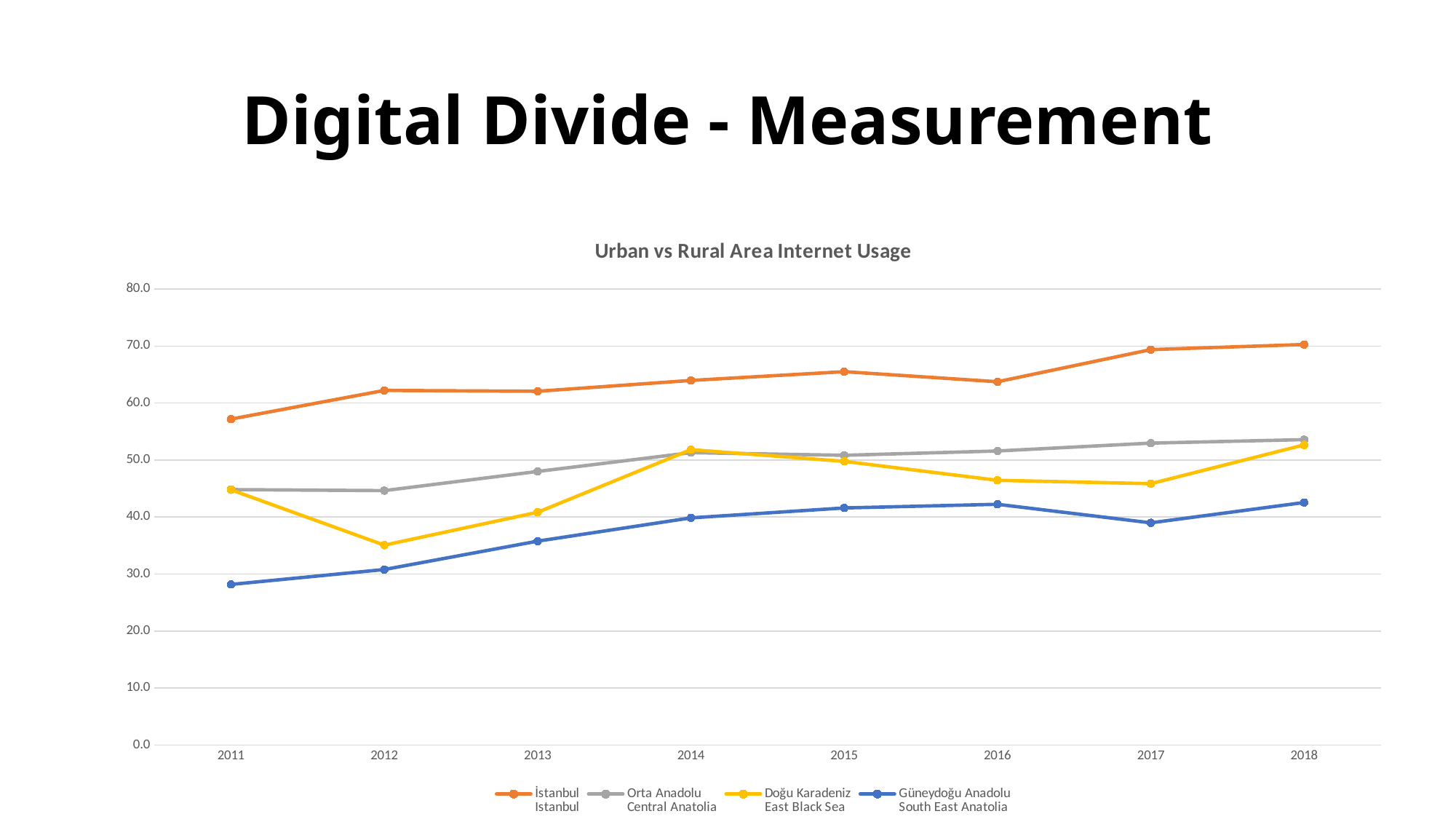
Which series has the highest value in 2018? İstanbul Does the İstanbul series generally rise or fall from 2011 to 2018? rise Is the value for Orta Anadolu in 2018 greater or less than 50? greater What is the title of the chart? Urban vs Rural Area Internet Usage How many years are shown on the x axis? 8 Is the value for Doğu Karadeniz in 2012 greater or less than 40? less Is the value for İstanbul in 2011 greater or less than 50? greater What kind of chart is shown on the slide? line chart Which series has the lowest value in 2011? Güneydoğu Anadolu (South East Anatolia) How many series does the legend list? 4 In 2012, which is larger: the value for Orta Anadolu or the value for Doğu Karadeniz? Orta Anadolu